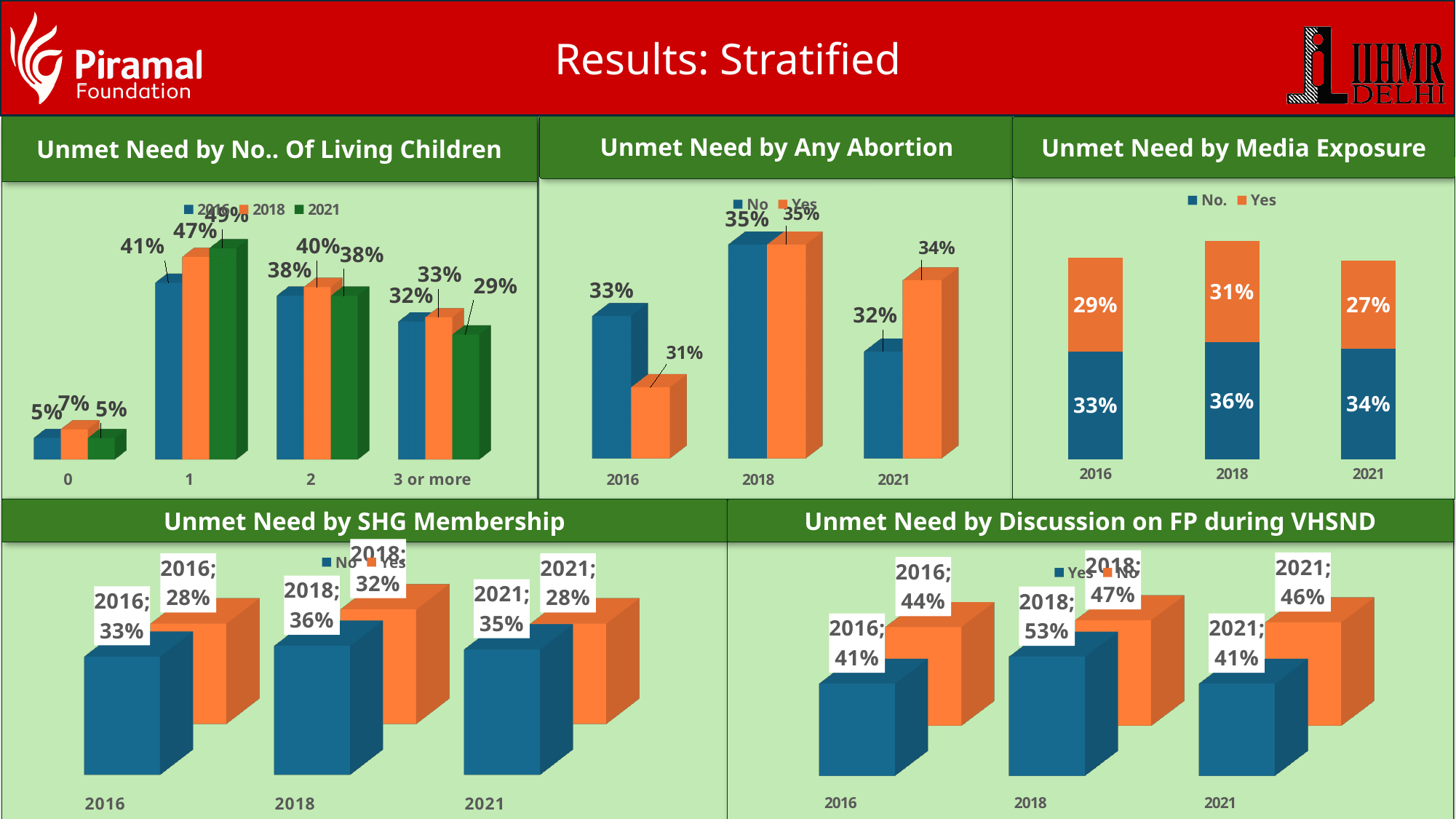
In the 'Unmet Need by Any Abortion' chart, what is the 'Yes' value for 2016? 31% In the 'Unmet Need by No.. Of Living Children' chart, which category has the lowest values across all years? 0 In the 'Unmet Need by Discussion on FP during VHSND' chart, which year has the highest 'Yes' value? 2018 In the 'Unmet Need by SHG Membership' chart, what is the 'No' value for 2018? 36% In the 'Unmet Need by Media Exposure' chart, what is the total of the stacked bar for 2018? 67% In the 'Unmet Need by No.. Of Living Children' chart, what is the 2021 value for the '1' category? 49% In the 'Unmet Need by No.. Of Living Children' chart, how many series does the legend list? 3 In the 'Unmet Need by Media Exposure' chart, what is the 'Yes' value for 2021? 27% In the 'Unmet Need by Any Abortion' chart, which is larger in 2021, 'No' or 'Yes'? Yes In the 'Unmet Need by No.. Of Living Children' chart, what is the difference between the 2018 and 2021 values for '3 or more'? 4% In the 'Unmet Need by Discussion on FP during VHSND' chart, what is the difference between the 'No' and 'Yes' values for 2021? 5% What kind of chart is 'Unmet Need by Media Exposure'? Stacked bar chart